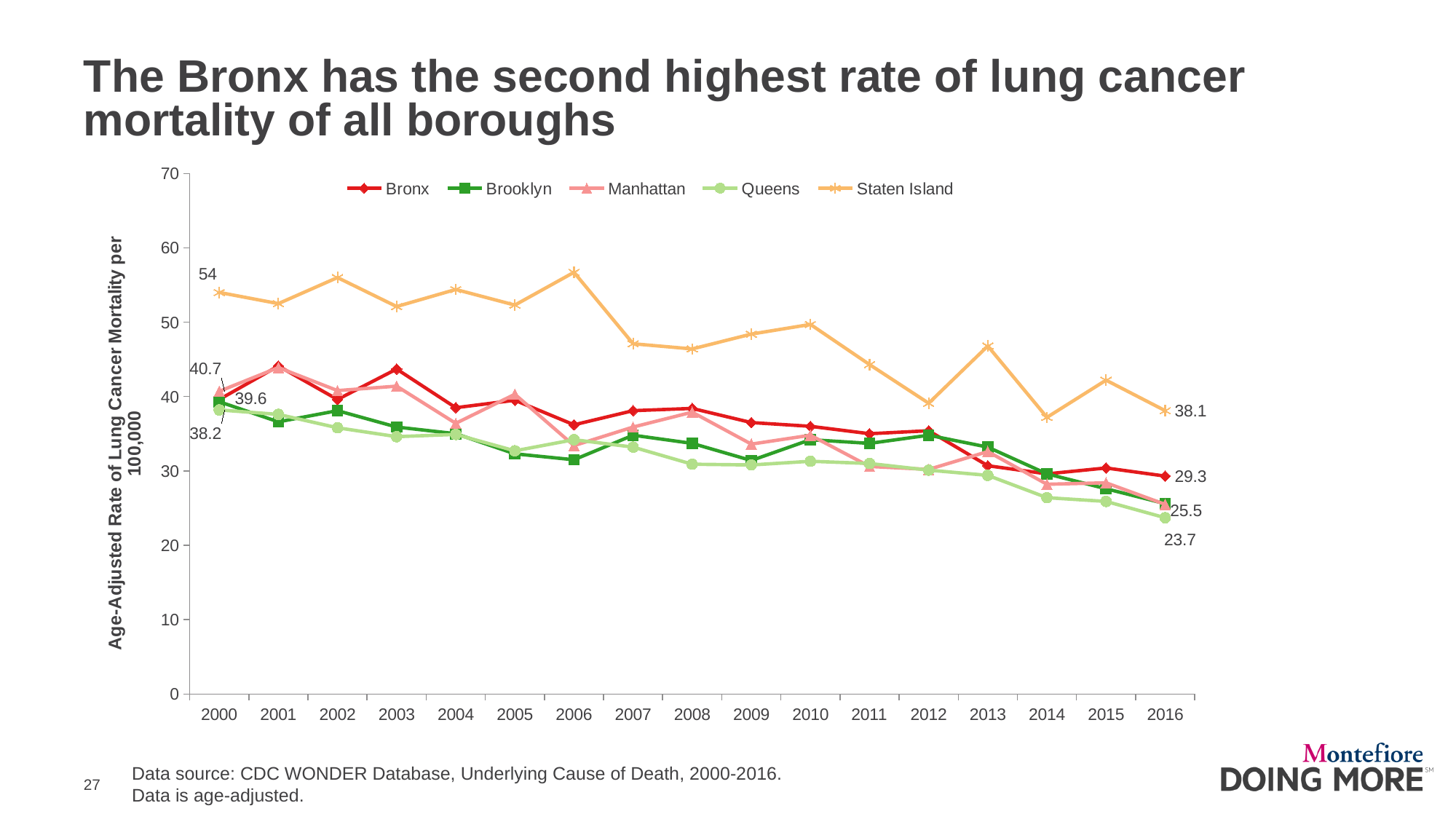
By how much did Staten Island's rate fall from 2000 to 2016? 15.9 Which borough has the lowest lung cancer mortality rate in 2016? Queens What is the lung cancer mortality rate for the Bronx in 2016? 29.3 How many series does the legend list? 5 What type of chart is shown on the slide? line chart How many years are plotted along the x axis? 17 What is the lung cancer mortality rate for Queens in 2016? 23.7 What is the difference between the Bronx and Queens rates in 2016? 5.6 What is the lung cancer mortality rate for Staten Island in 2016? 38.1 What is the lung cancer mortality rate for Staten Island in 2000? 54 Which borough has the highest lung cancer mortality rate in 2016? Staten Island